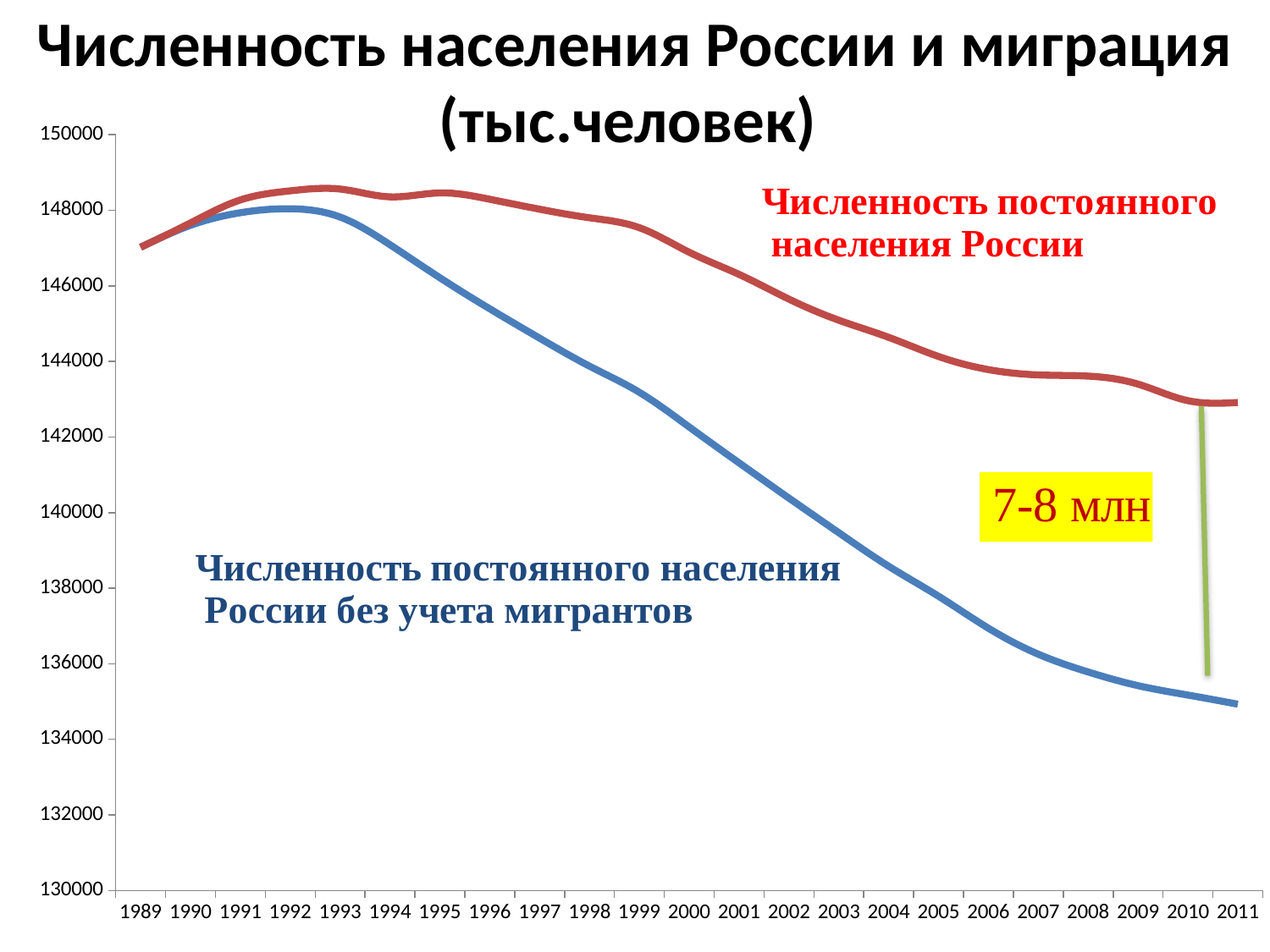
Is the value of the red line (Численность постоянного населения России) in 2011 greater or less than 142000? greater What value is written in the yellow box on the chart? 7-8 млн Is the value of the blue line (без учета мигрантов) in 1999 greater or less than 144000? less What is the first year shown on the x axis? 1989 Does the red line (Численность постоянного населения России) rise or fall from 1999 to 2011? fall Does the blue line (Численность постоянного населения России без учета мигрантов) rise or fall from 1993 to 2011? fall Is the value of the blue line (без учета мигрантов) in 2011 greater or less than 136000? less How many years are shown along the x axis of the chart? 23 In 2011, which series has the larger value: Численность постоянного населения России or Численность постоянного населения России без учета мигрантов? Численность постоянного населения России What kind of chart is shown on the slide? line chart In which year does the blue line (без учета мигрантов) reach its lowest value? 2011 How many data series are plotted on the chart? 2